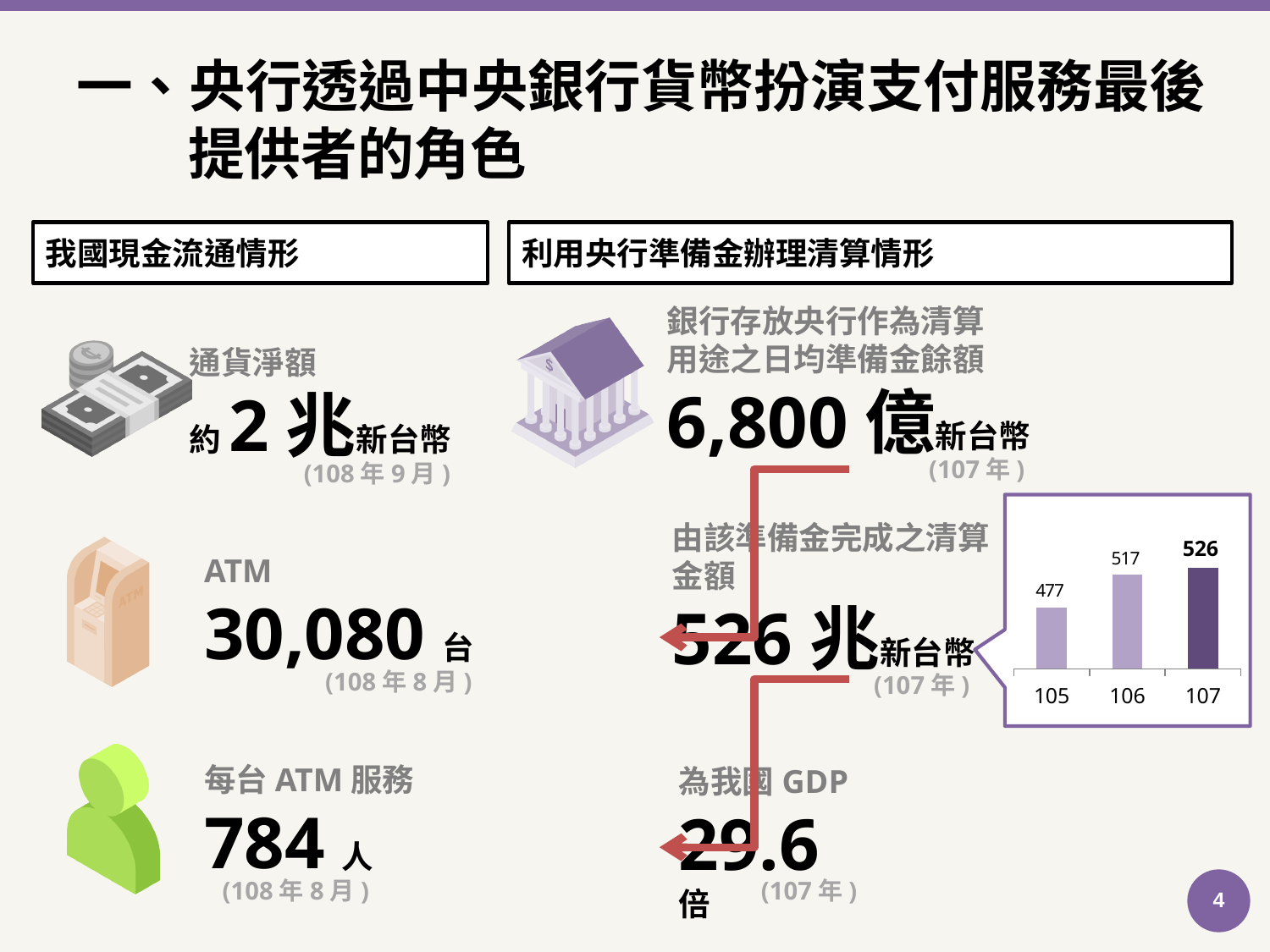
What kind of chart is shown on the slide? bar chart What is the difference between the values for 106 and 105 in the bar chart? 40 Which category has the highest value in the bar chart? 107 What is the value for 105 in the bar chart? 477 What is the value for 106 in the bar chart? 517 How many bars are in the bar chart? 3 Which category has the lowest value in the bar chart? 105 What is the value for 107 in the bar chart? 526 Do the values in the bar chart rise or fall from 105 to 107? rise Which is larger in the bar chart, the value for 105 or the value for 106? 106 What is the difference between the values for 107 and 105 in the bar chart? 49 Which bar in the chart is drawn in the darkest colour? 107